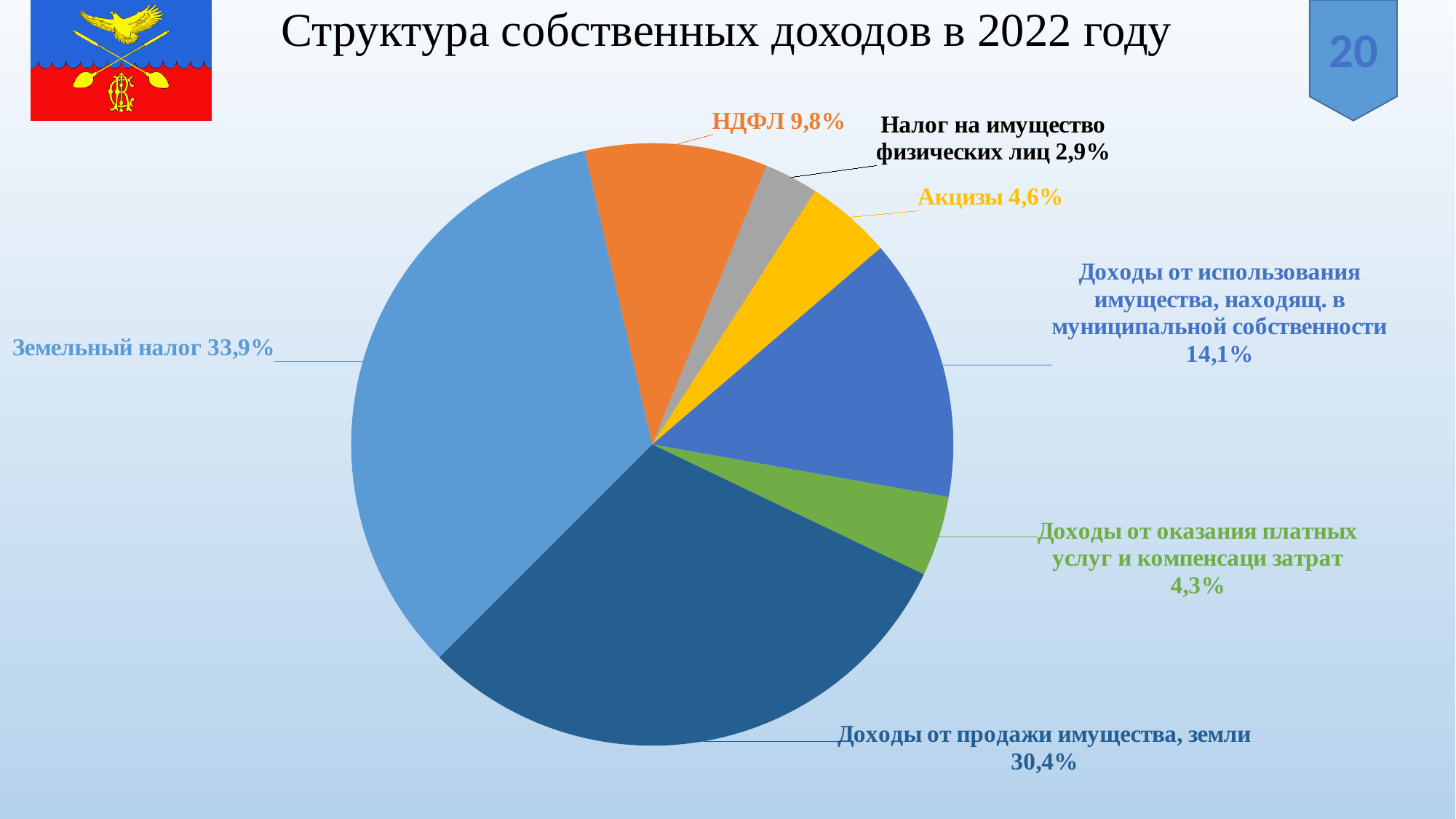
What is the title of the chart on the slide? Структура собственных доходов в 2022 году What percentage is shown for Акцизы? 4,6% How many slices does the pie chart have? 7 What share of own revenues does Земельный налог account for? 33,9% What is the share of Доходы от продажи имущества, земли? 30,4% Which category has the smallest slice of the pie? Налог на имущество физических лиц What is the difference in percentage points between Земельный налог and Доходы от продажи имущества, земли? 3,5 Which category has the largest slice of the pie? Земельный налог What colour is the slice for Доходы от оказания платных услуг и компенсаци затрат? Green What type of chart is shown on the slide? Pie chart What is the value shown for НДФЛ? 9,8% Which is larger: Акцизы or Доходы от оказания платных услуг и компенсаци затрат? Акцизы